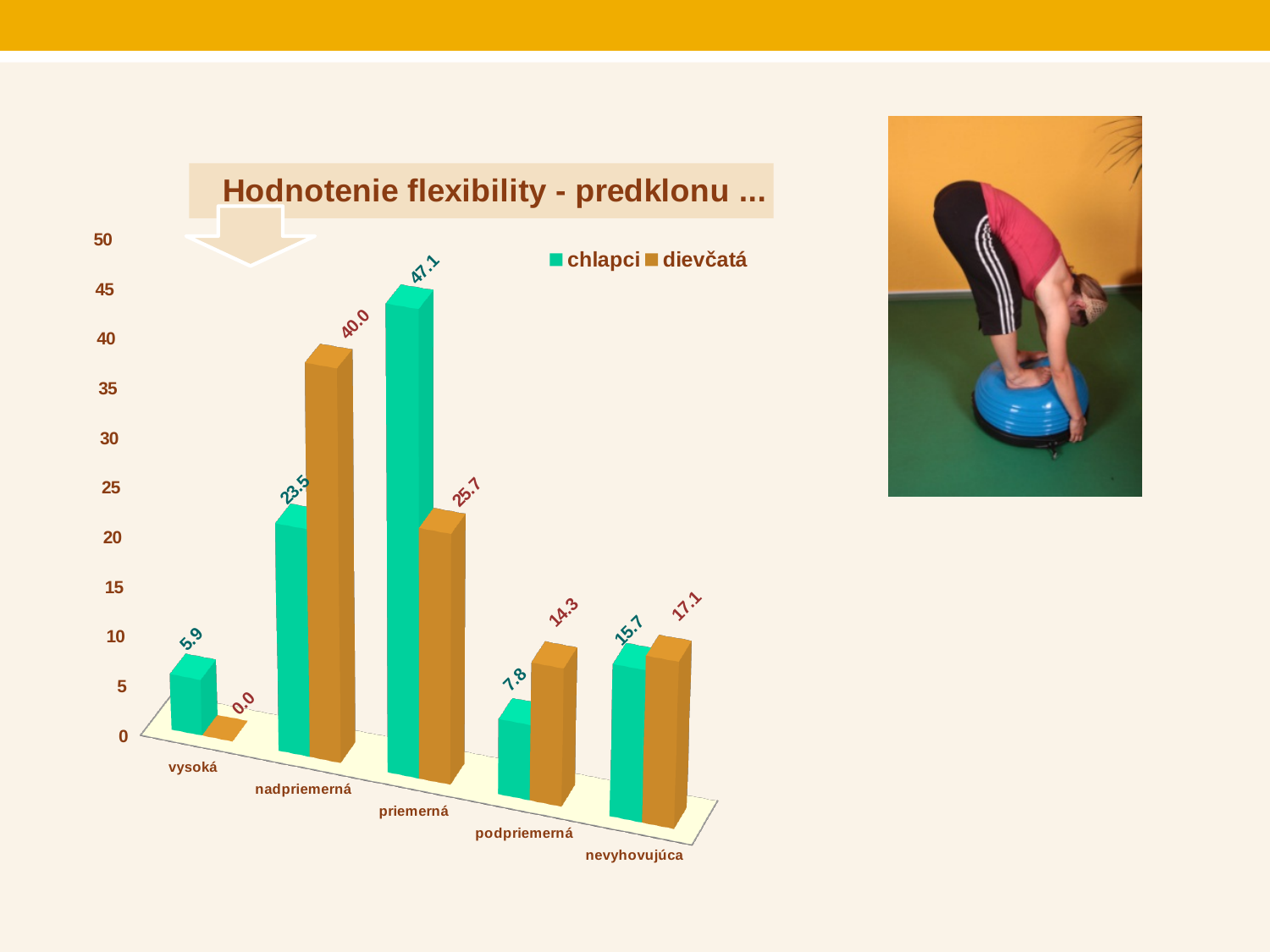
How many series does the legend list? 2 In the podpriemerná category, which series has the larger value, chlapci or dievčatá? dievčatá What is the difference between the dievčatá and chlapci values in the nadpriemerná category? 16.5 What is the value for chlapci in the priemerná category? 47.1 What is the value for chlapci in the podpriemerná category? 7.8 How many categories are shown on the x axis? 5 What is the title of the chart? Hodnotenie flexibility - predklonu ... What is the value for dievčatá in the vysoká category? 0.0 Which category has the highest value for chlapci? priemerná Which category has the lowest value for dievčatá? vysoká What kind of chart is shown on the slide? bar chart What is the value for dievčatá in the nadpriemerná category? 40.0